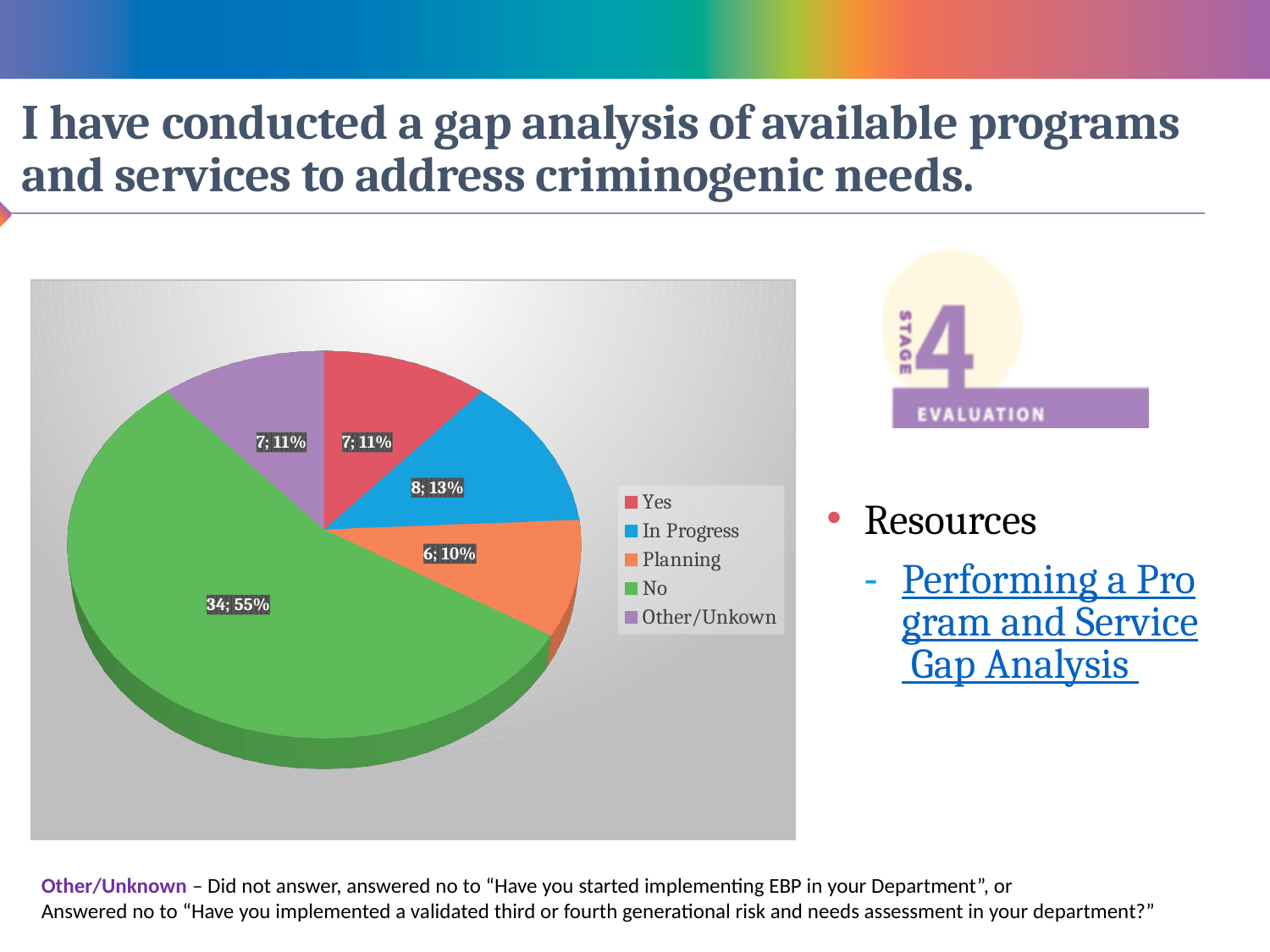
Which category has the smallest slice of the pie chart? Planning How many categories does the pie chart show? 5 Which category has the largest slice of the pie chart? No What is the count for the "In Progress" slice? 8 Which is larger, the "In Progress" slice or the "Planning" slice? In Progress What is the count for the "No" slice of the pie chart? 34 What is the difference in count between the "No" slice and the "In Progress" slice? 26 What is the total count across all slices of the pie chart? 62 What percentage of the pie does the "Planning" slice represent? 10% What type of chart is shown on the slide? Pie chart What percentage of the pie does the "No" slice represent? 55% Which legend entry is shown in green? No